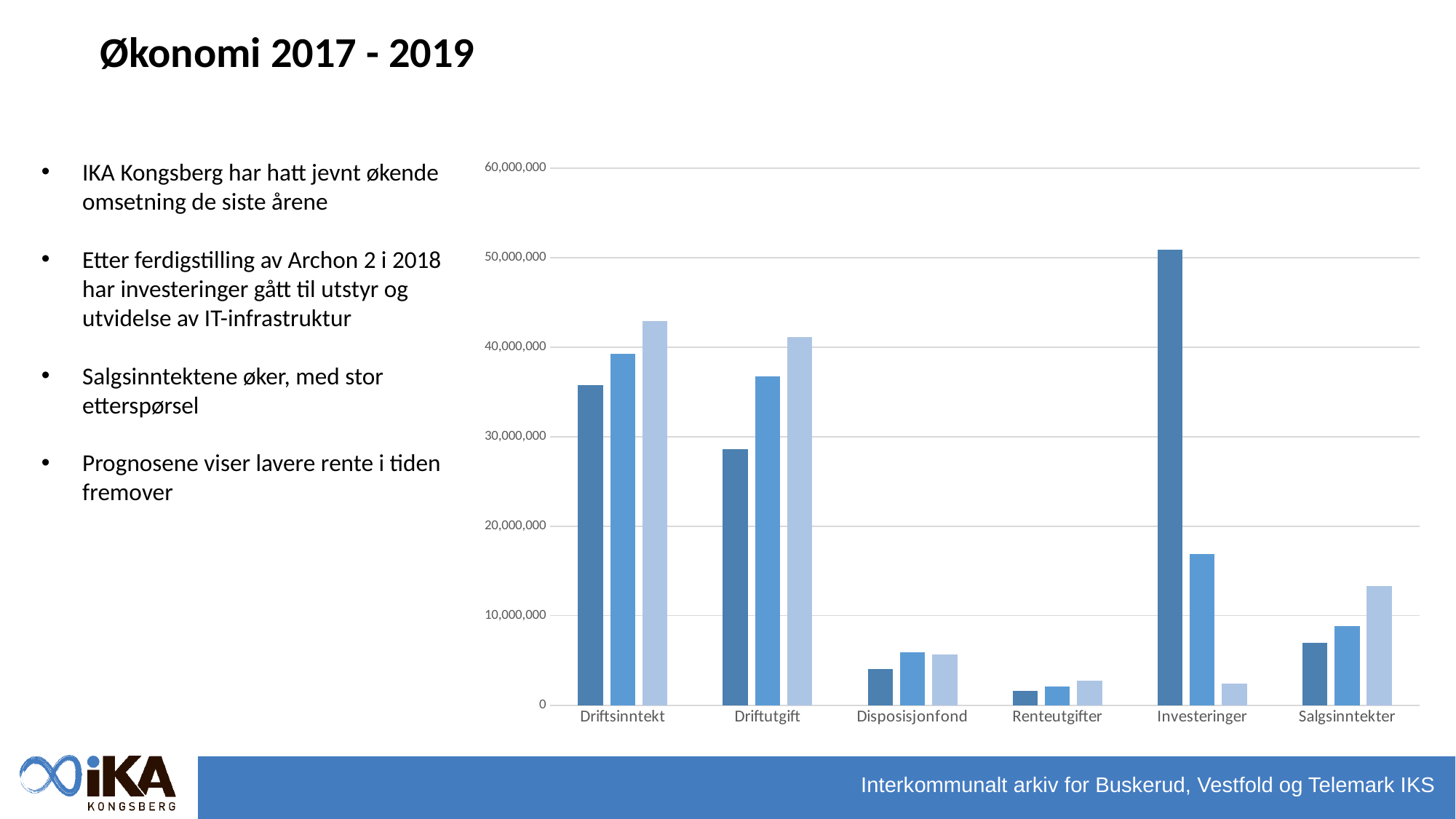
Is the value of the first (darkest) bar for Investeringer greater or less than 40,000,000? greater Do the three bars for Investeringer rise or fall from left to right? fall How many bars are plotted for each category in the chart? 3 Is the value of the first (darkest) bar for Driftsinntekt greater or less than 30,000,000? greater Is the value of the third (lightest) bar for Salgsinntekter greater or less than 10,000,000? greater Do the three bars for Driftsinntekt rise or fall from left to right? rise Which category contains the tallest bar in the chart? Investeringer How many categories are shown on the x axis of the chart? 6 Which category contains the shortest bar in the chart? Renteutgifter What kind of chart is shown on the slide? bar chart Which is larger: the third (lightest) bar for Driftsinntekt or the third (lightest) bar for Driftutgift? Driftsinntekt